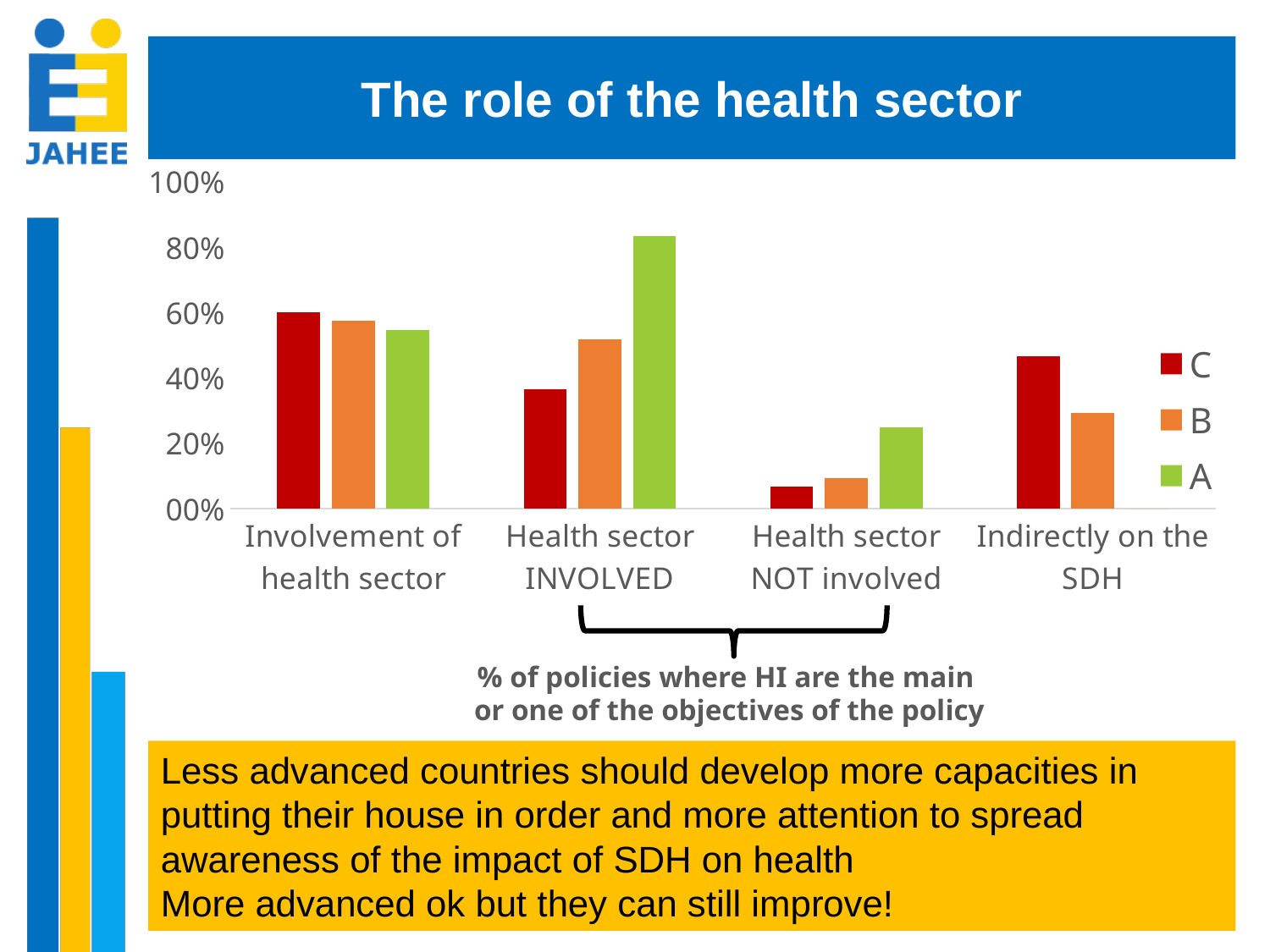
Is the value for series B in 'Indirectly on the SDH' greater or less than 40%? less How many series does the legend list? 3 In 'Health sector NOT involved', which series has the lowest value? C What kind of chart is shown on the slide? bar chart Is the value for series A in 'Health sector INVOLVED' greater or less than 60%? greater Is the value for series C in 'Involvement of health sector' greater or less than 40%? greater What is the title of the chart? The role of the health sector In 'Health sector INVOLVED', which series has the highest value? A How many categories are shown on the x axis? 4 In 'Indirectly on the SDH', which is larger, series C or series B? C What are the series names listed in the legend? C, B, A